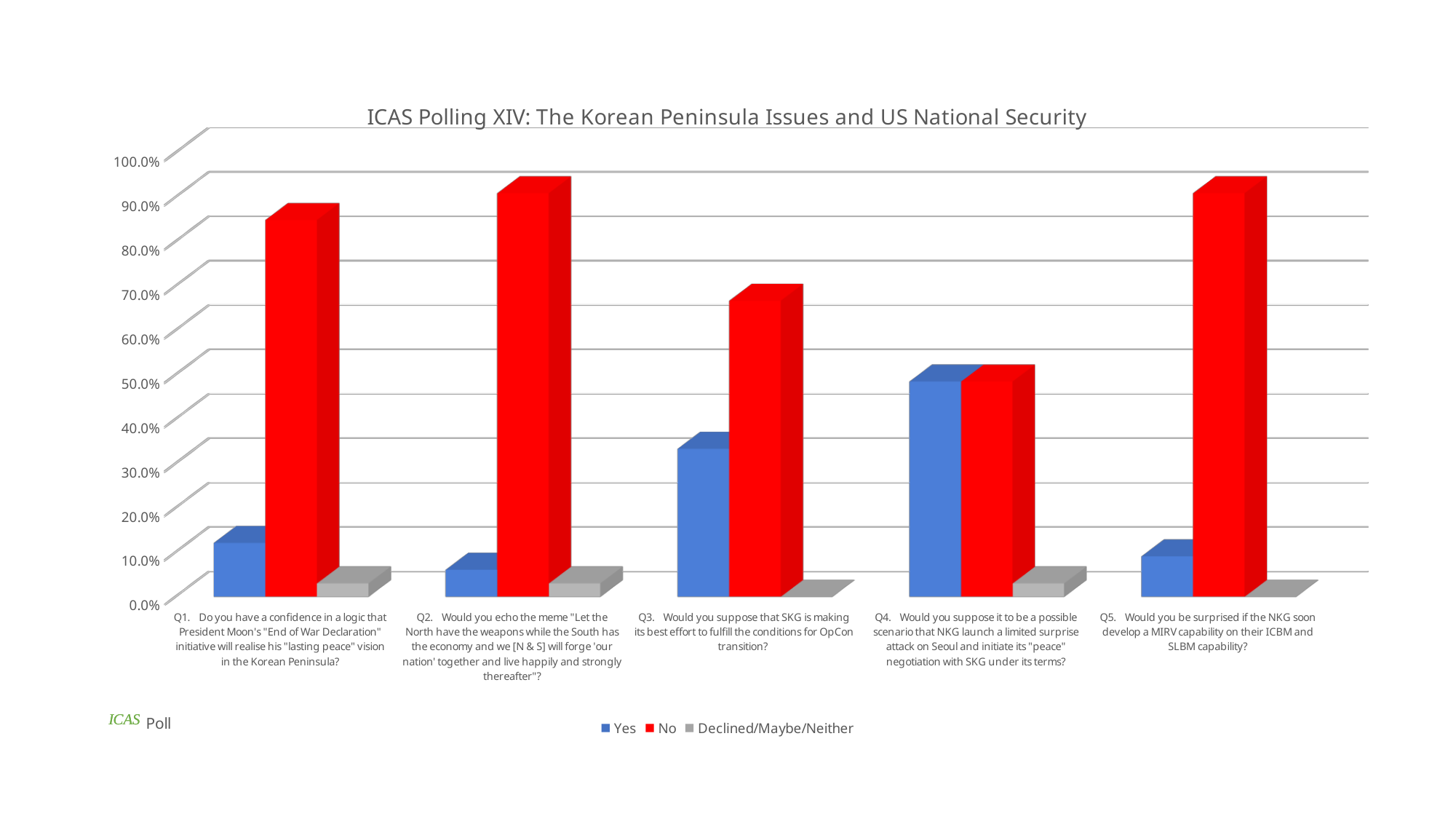
How many questions (categories) are shown along the x axis? 5 Which question has the lowest "No" value? Q4 Which question has the highest "Yes" value? Q4 How many series does the legend list? 3 What is the title of the chart? ICAS Polling XIV: The Korean Peninsula Issues and US National Security Is the "Yes" value for Q3 greater or less than 40.0%? less Is the "No" value for Q1 greater or less than 80.0%? greater For Q3, which is larger, the "Yes" value or the "No" value? No Is the "No" value for Q3 greater or less than 60.0%? greater What kind of chart is shown on the slide? bar chart Which colour represents the "No" series in the chart? red